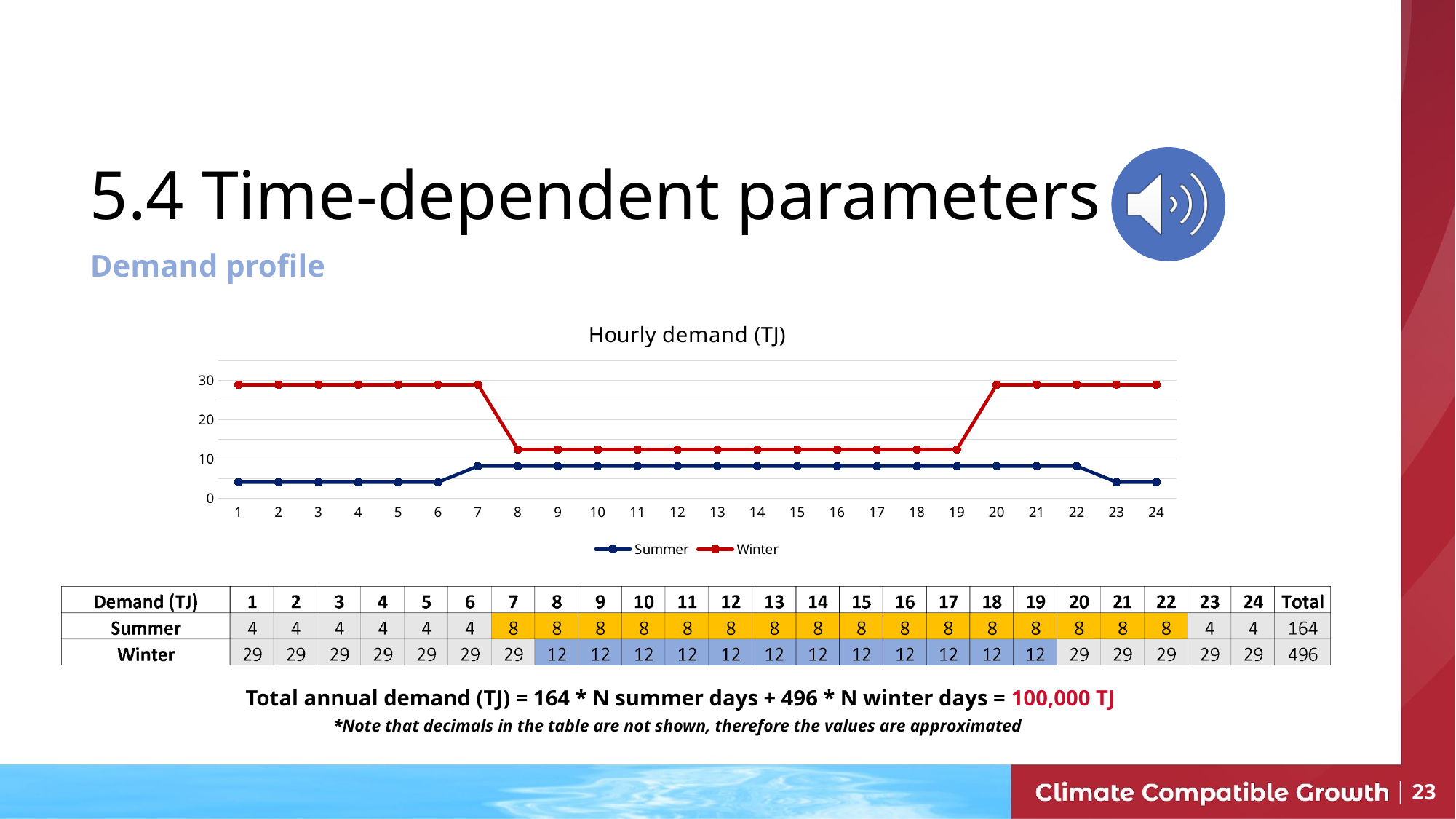
What kind of chart is shown on the slide? line chart What is the Total Winter demand (TJ) shown in the table? 496 Which series has the higher value at hour 1, Summer or Winter? Winter Using the table values, what is the difference between the Winter and Summer demand at hour 1? 25 According to the table, what is the Summer demand (TJ) at hour 15? 8 What is the title of the chart? Hourly demand (TJ) According to the table, what is the Summer demand (TJ) at hour 3? 4 According to the table, what is the Winter demand (TJ) at hour 12? 12 How many series does the chart legend list? 2 Is the Winter value at hour 5 greater or less than 20? greater How many hours (points) are plotted along the x axis of the chart? 24 Is the Summer value at hour 10 greater or less than 10? less